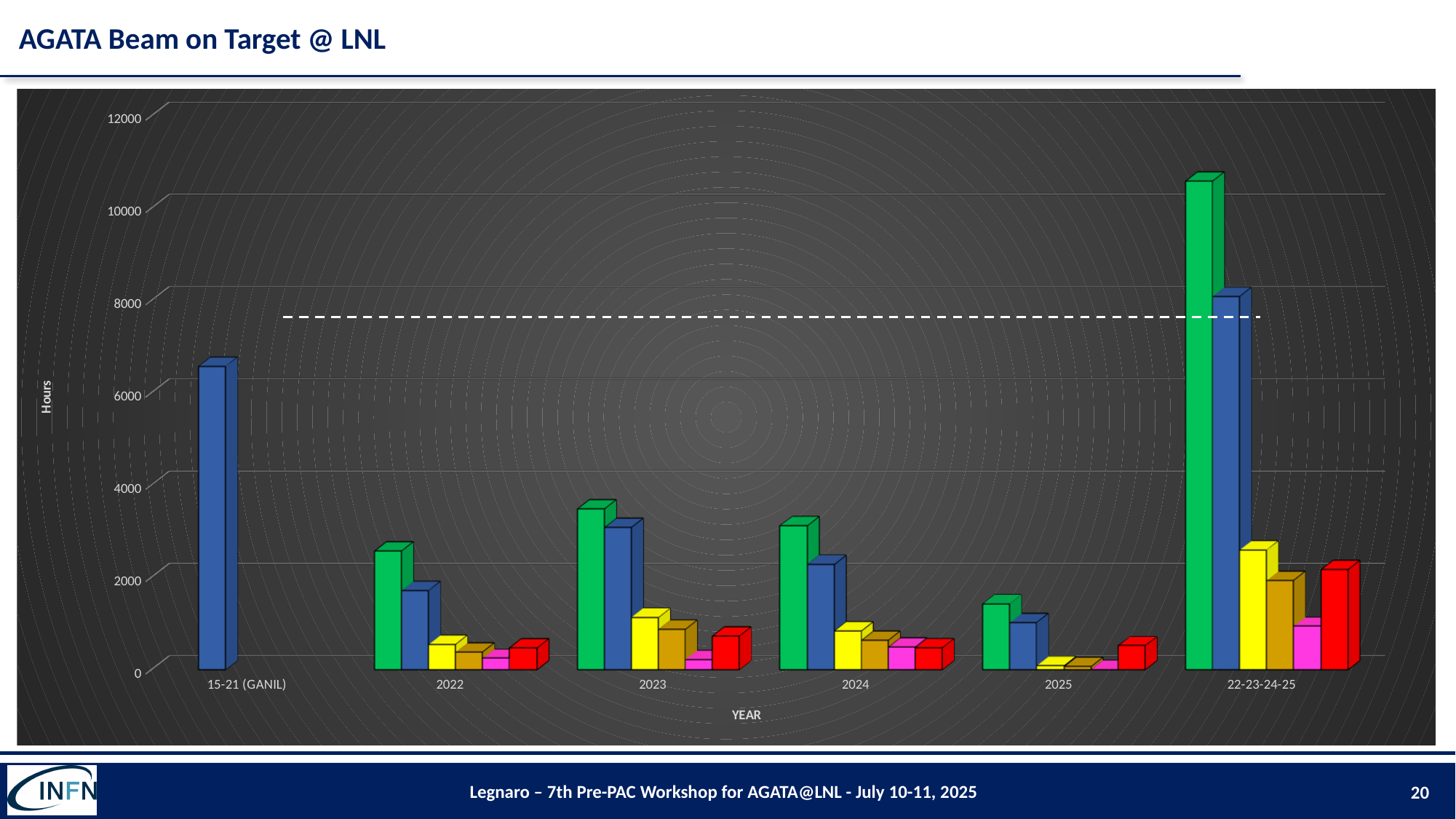
Is the value of the green bar for 2023 greater or less than 4000? less How many categories are shown on the x axis of the chart? 6 Is the value of the green bar for 2022 greater or less than 2000? greater What is the title of the vertical axis of the chart? Hours Which category has the tallest bar in the chart? 22-23-24-25 Which is larger, the green bar for 2022 or the green bar for 2023? 2023 Is the value of the blue bar for 15-21 (GANIL) greater or less than 6000? greater Which is larger, the blue bar for 15-21 (GANIL) or the blue bar for 22-23-24-25? 22-23-24-25 What kind of chart is shown on the slide? bar chart What is the title of the horizontal axis of the chart? YEAR